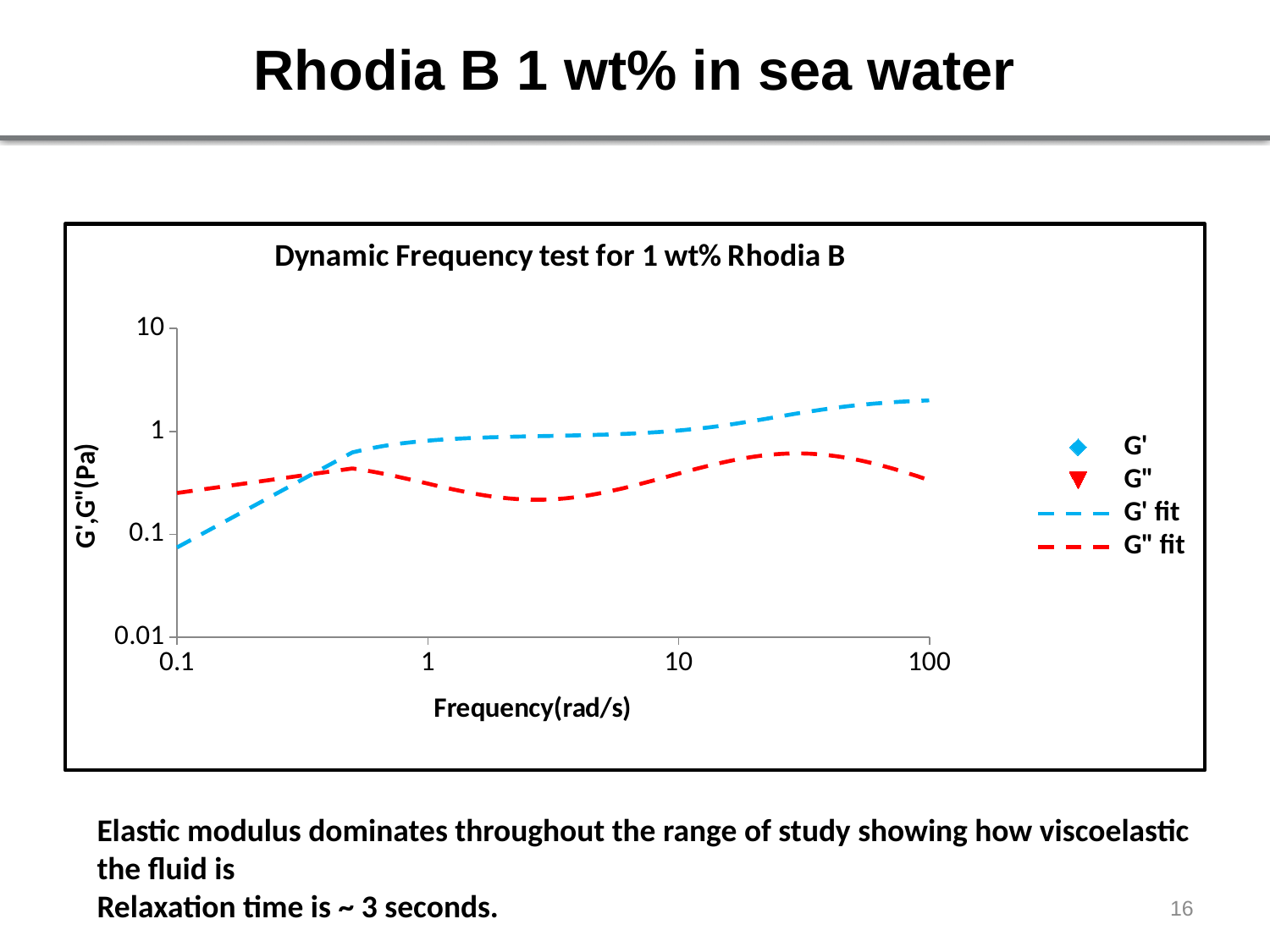
Is the value of the G' fit line at 0.1 rad/s greater or less than 0.1? less Is the value of the G" fit line at 0.1 rad/s greater or less than 0.1? greater Is the value of the G' fit line at 100 rad/s greater or less than 1? greater What kind of chart is shown on the slide? line chart Does the G' fit line generally rise or fall as frequency increases? rise What is the label of the x axis? Frequency(rad/s) At 100 rad/s, which line is higher, G' fit or G" fit? G' fit How many series does the chart legend list? 4 Which series has the highest value at the right end of the x axis (100 rad/s)? G' fit What is the title of the chart? Dynamic Frequency test for 1 wt% Rhodia B At 0.1 rad/s, which line is higher, G' fit or G" fit? G" fit